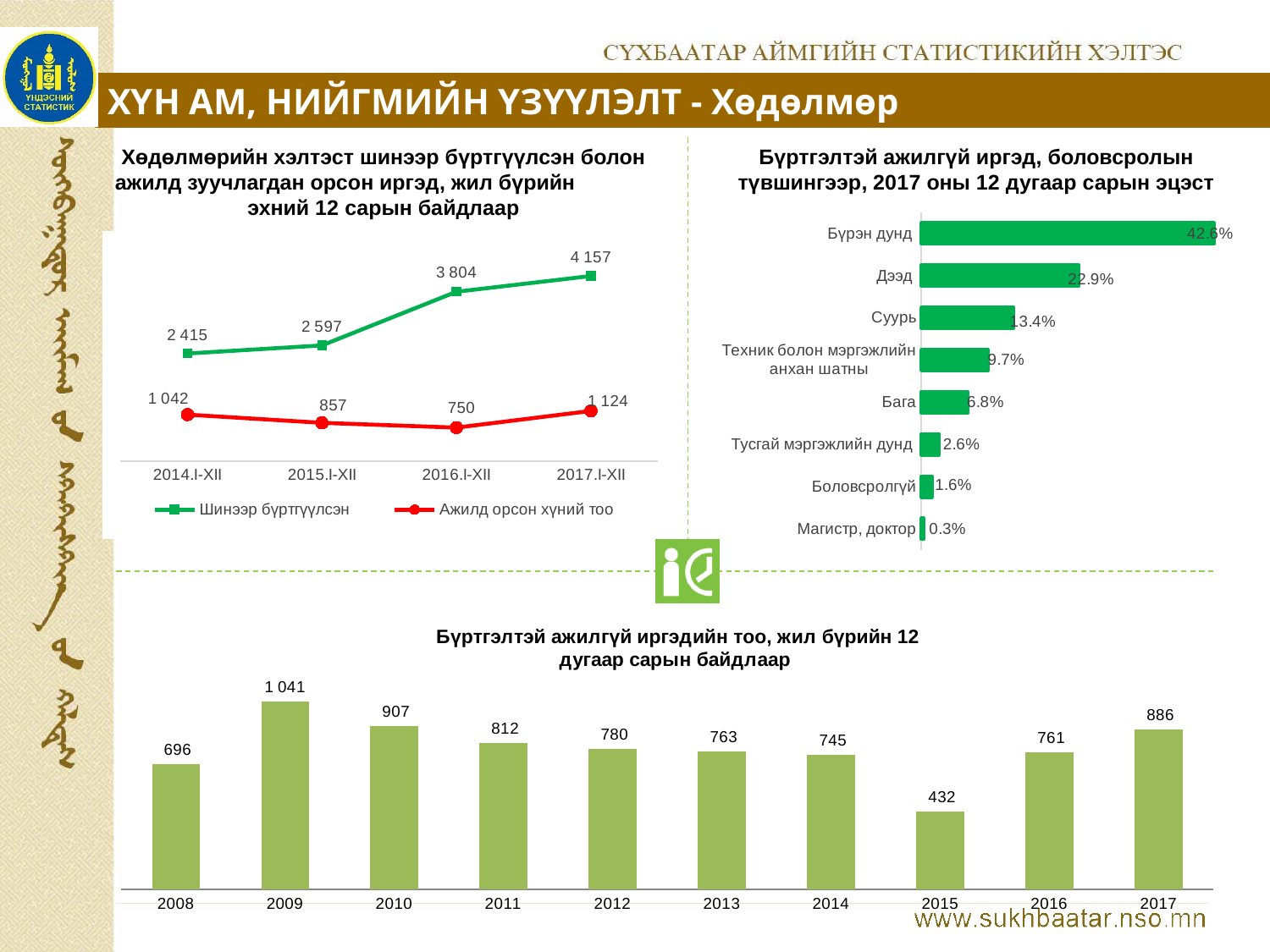
In the bottom chart, what is the value for 2015? 432 In the top-left chart, what is the value of Ажилд орсон хүний тоо for 2016.I-XII? 750 In the top-left chart, what is the difference between Шинээр бүртгүүлсэн and Ажилд орсон хүний тоо for 2014.I-XII? 1 373 In the top-right chart, how many education categories are shown? 8 In the bottom chart, which year has the highest value? 2009 In the top-right chart, which is larger: Суурь or Бага? Суурь In the top-right chart, which education level has the lowest share? Магистр, доктор In the top-left chart, what is the value of Шинээр бүртгүүлсэн for 2017.I-XII? 4 157 What type of chart is the bottom chart? bar chart In the top-left chart, does the Шинээр бүртгүүлсэн series rise or fall from 2014.I-XII to 2017.I-XII? rise In the top-right chart, what is the share for Дээд? 22.9% In the top-left chart, how many series does the legend list? 2